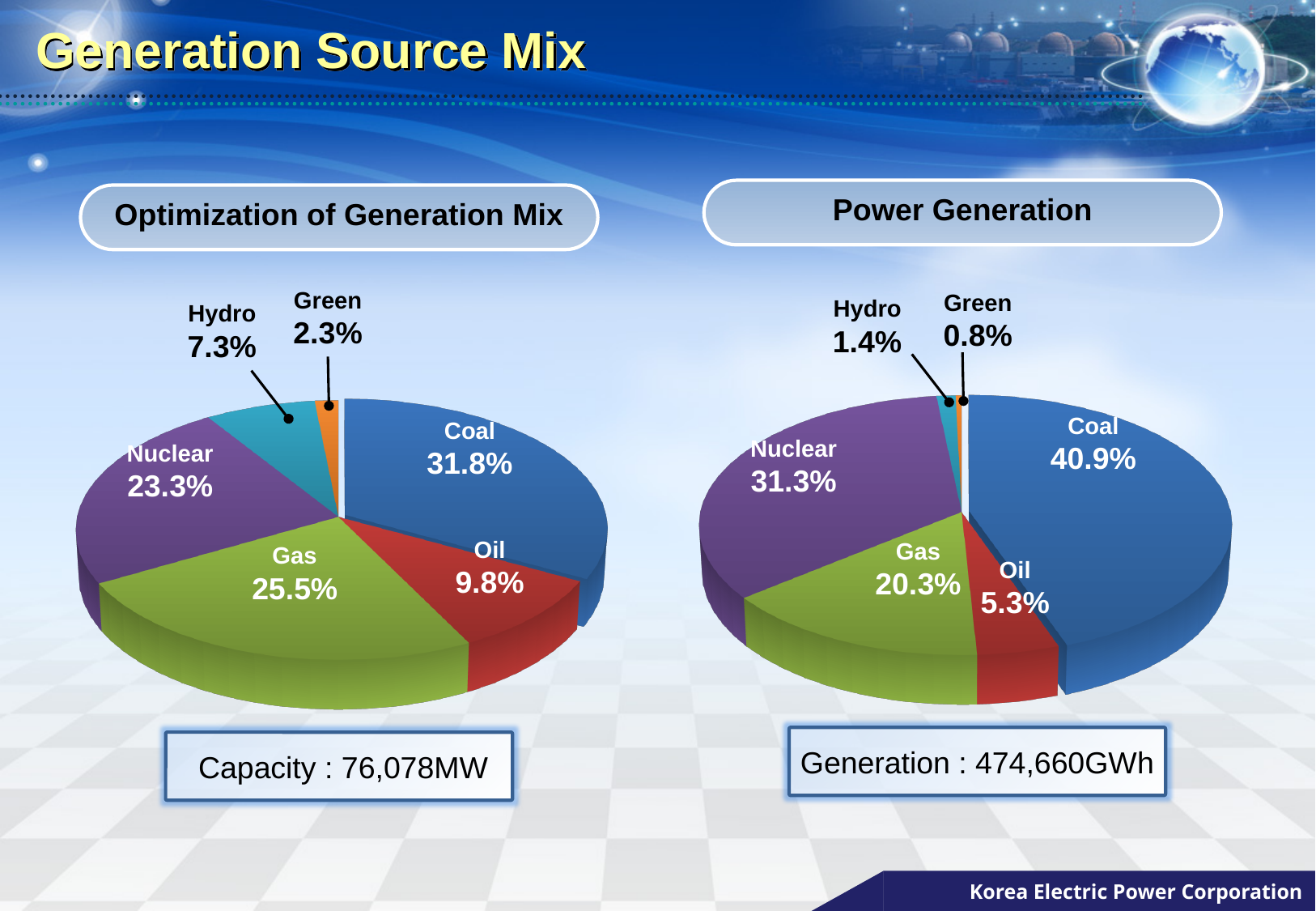
In the 'Optimization of Generation Mix' pie chart, which is larger, the Hydro share or the Oil share? Oil In the 'Power Generation' pie chart, which is larger, the Gas share or the Oil share? Gas In the 'Power Generation' pie chart, which source has the smallest share? Green What total capacity is stated below the 'Optimization of Generation Mix' pie chart? 76,078MW In the 'Power Generation' pie chart, what is the difference between the Coal share and the Nuclear share? 9.6% In the 'Optimization of Generation Mix' pie chart, which source has the largest share? Coal In the 'Power Generation' pie chart, what share does Nuclear have? 31.3% What type of chart is used under 'Optimization of Generation Mix'? Pie chart In the 'Optimization of Generation Mix' pie chart, what is the difference between the Gas share and the Nuclear share? 2.2% In the 'Optimization of Generation Mix' pie chart, what share does Coal have? 31.8% How many slices does the 'Power Generation' pie chart have? 6 In the 'Optimization of Generation Mix' pie chart, what share does Hydro have? 7.3%